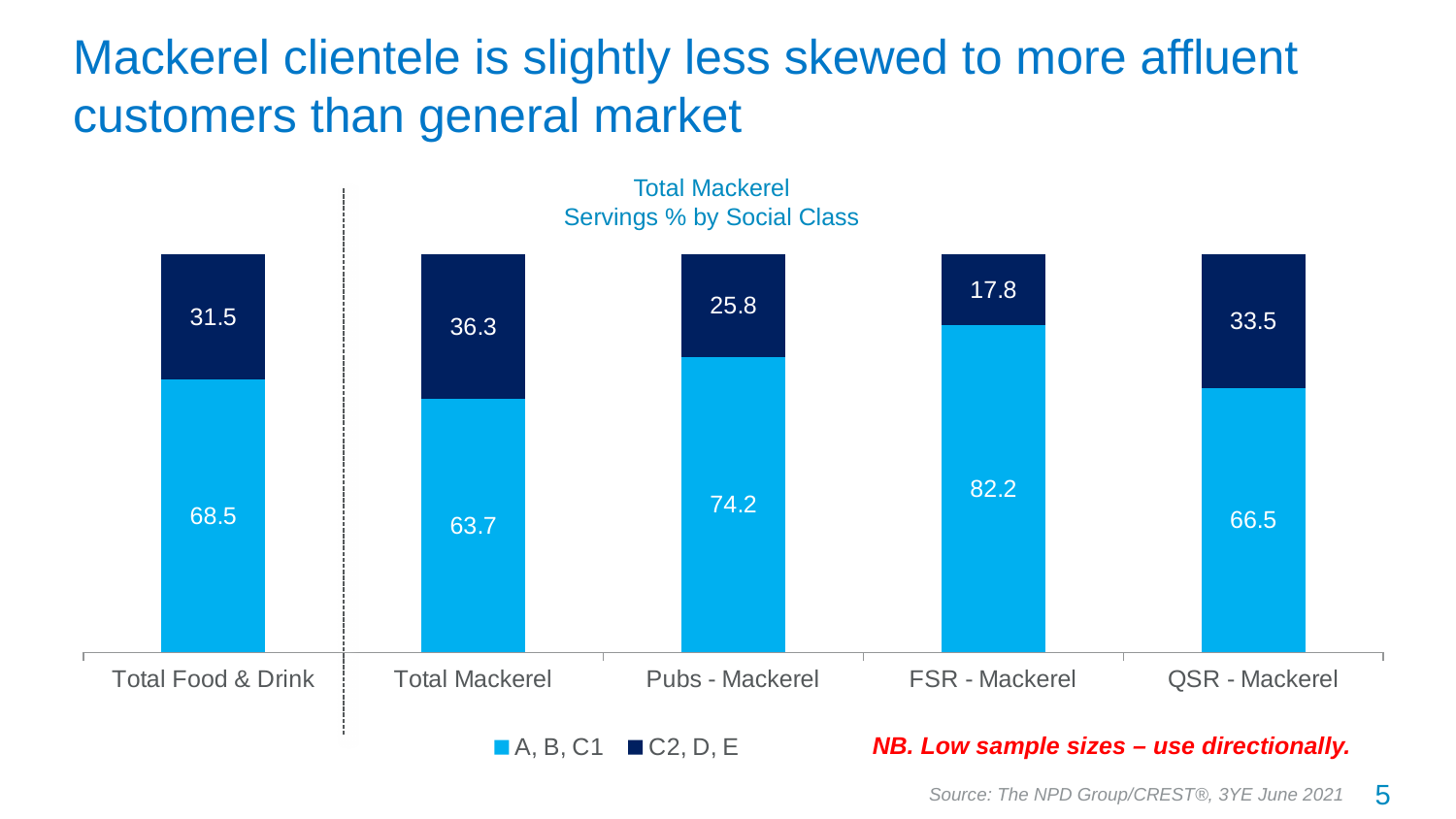
Which is larger: the C2, D, E value for Total Mackerel or for QSR - Mackerel? Total Mackerel Which category has the highest A, B, C1 value? FSR - Mackerel What is the difference between the A, B, C1 values for Pubs - Mackerel and Total Mackerel? 10.5 What is the title of the chart? Total Mackerel Servings % by Social Class What is the C2, D, E value for Total Mackerel? 36.3 What is the A, B, C1 value for Total Food & Drink? 68.5 What is the A, B, C1 value for FSR - Mackerel? 82.2 How many series does the legend list? 2 Which category has the lowest C2, D, E value? FSR - Mackerel How many categories are shown on the x axis? 5 What is the C2, D, E value for QSR - Mackerel? 33.5 What kind of chart is shown on the slide? Stacked bar chart